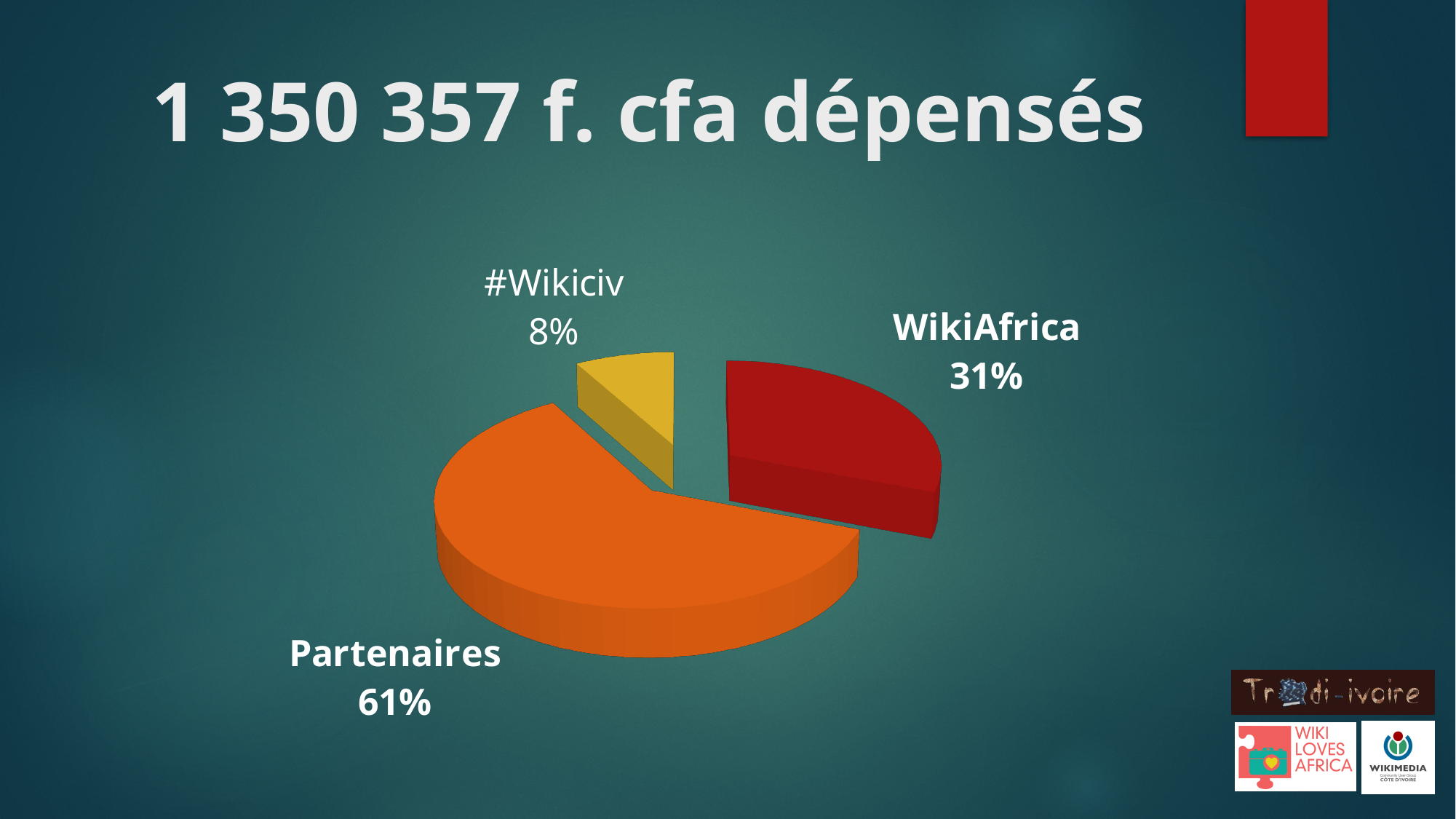
What share of the pie does Partenaires represent? 61% What share of the pie does WikiAfrica represent? 31% What is the difference in percentage points between Partenaires and WikiAfrica? 30 Which category has the largest slice of the pie? Partenaires What share of the pie does #Wikiciv represent? 8% Which is larger, the share for WikiAfrica or the share for #Wikiciv? WikiAfrica Which category has the smallest slice of the pie? #Wikiciv What is the title shown above the pie chart? 1 350 357 f. cfa dépensés What colour is the Partenaires slice? orange What is the difference in percentage points between WikiAfrica and #Wikiciv? 23 How many slices does the pie chart have? 3 What kind of chart is shown on the slide? pie chart